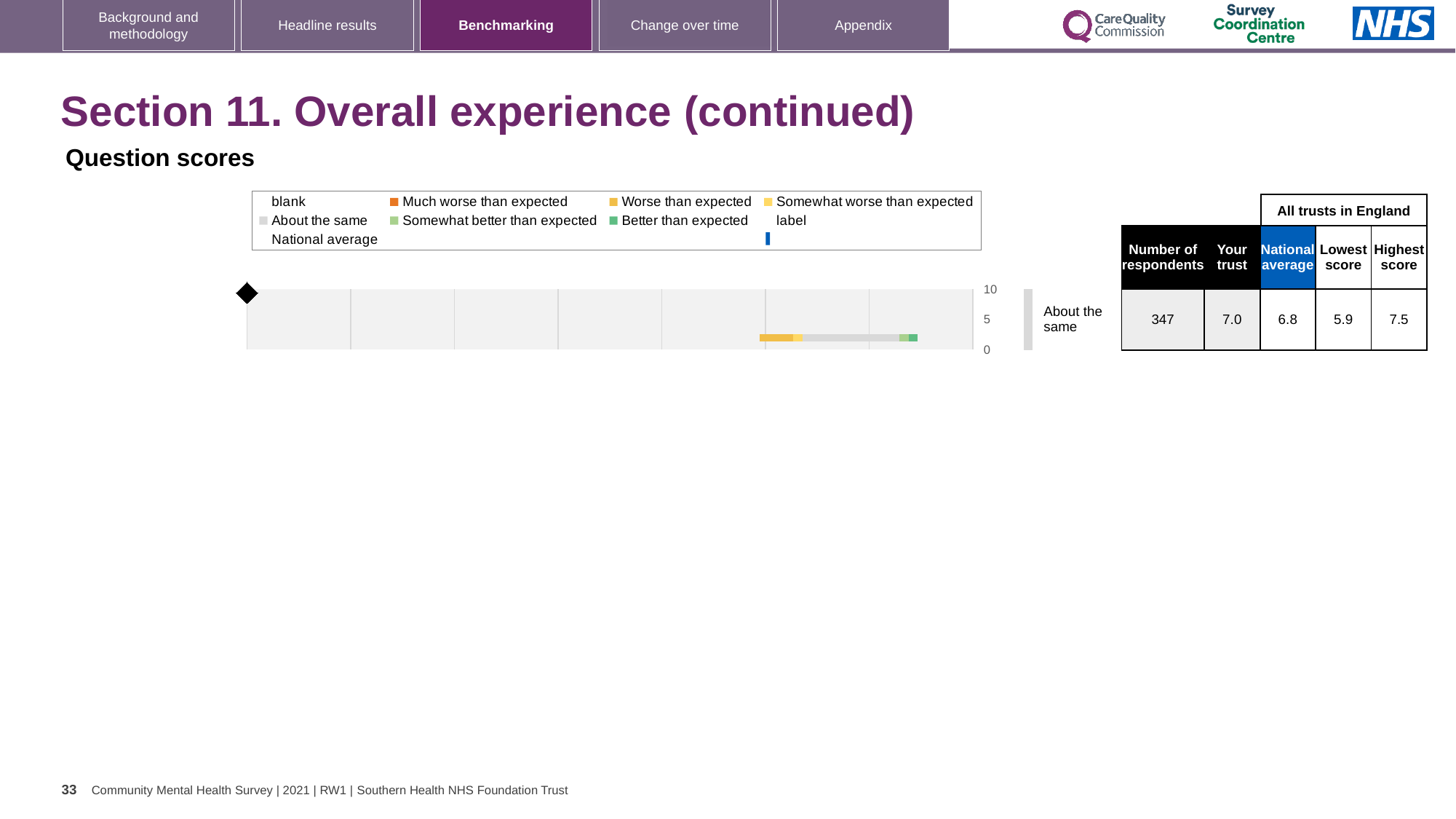
In the table beside the chart, what is the 'Your trust' score for the 'About the same' row? 7.0 What category label is shown next to the bar on the chart? About the same Which colour does the legend use for 'Much worse than expected'? orange In the table beside the chart, what is the Lowest score among all trusts in England? 5.9 What is the difference between the Highest score and the Lowest score in the table? 1.6 What kind of chart is shown on the slide? bar chart How many bars (categories) are plotted on the chart? 1 Which is larger, the 'Your trust' score or the National average score? Your trust What is the highest value shown on the chart's axis? 10 In the table beside the chart, what is the Number of respondents? 347 In the table beside the chart, what is the National average score? 6.8 In the table beside the chart, what is the Highest score among all trusts in England? 7.5